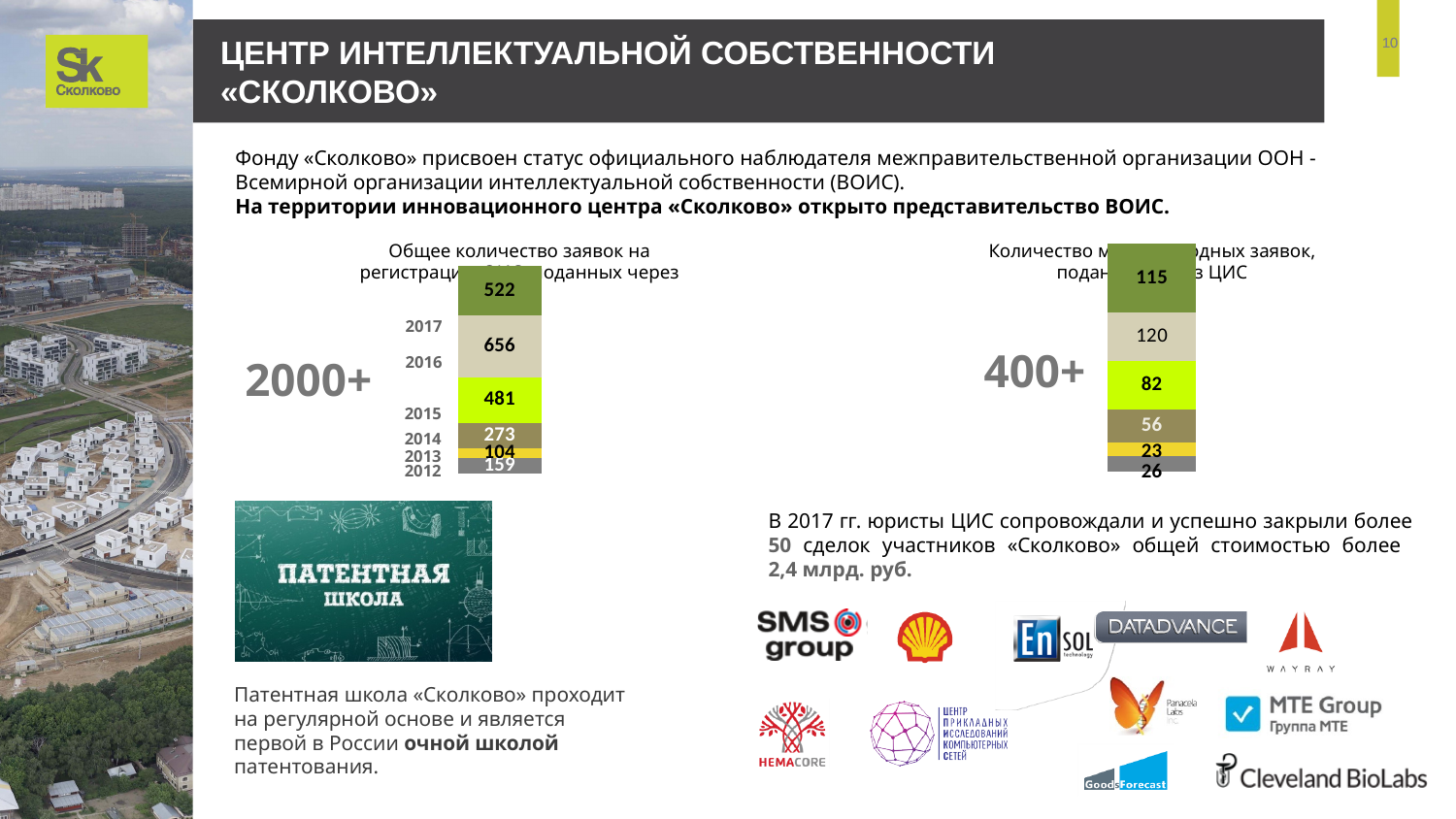
In the right chart, what is the total of all segments in the stacked bar? 422 In the left chart, what is the difference between the 656 segment and the 481 segment? 175 In the left chart, how many segments make up the stacked bar? 6 In the right chart, what is the largest segment value? 120 In the left chart, what is the total of all segments in the stacked bar? 2195 In the right chart, what is the smallest segment value? 23 What kind of chart is the left chart on the slide? stacked bar chart In the right chart, how many segments make up the stacked bar? 6 What kind of chart is the right chart on the slide? stacked bar chart In the left chart, what is the largest segment value? 656 In the left chart, what is the smallest segment value? 104 In the right chart, which is larger, the topmost segment (115) or the segment directly below it (120)? 120